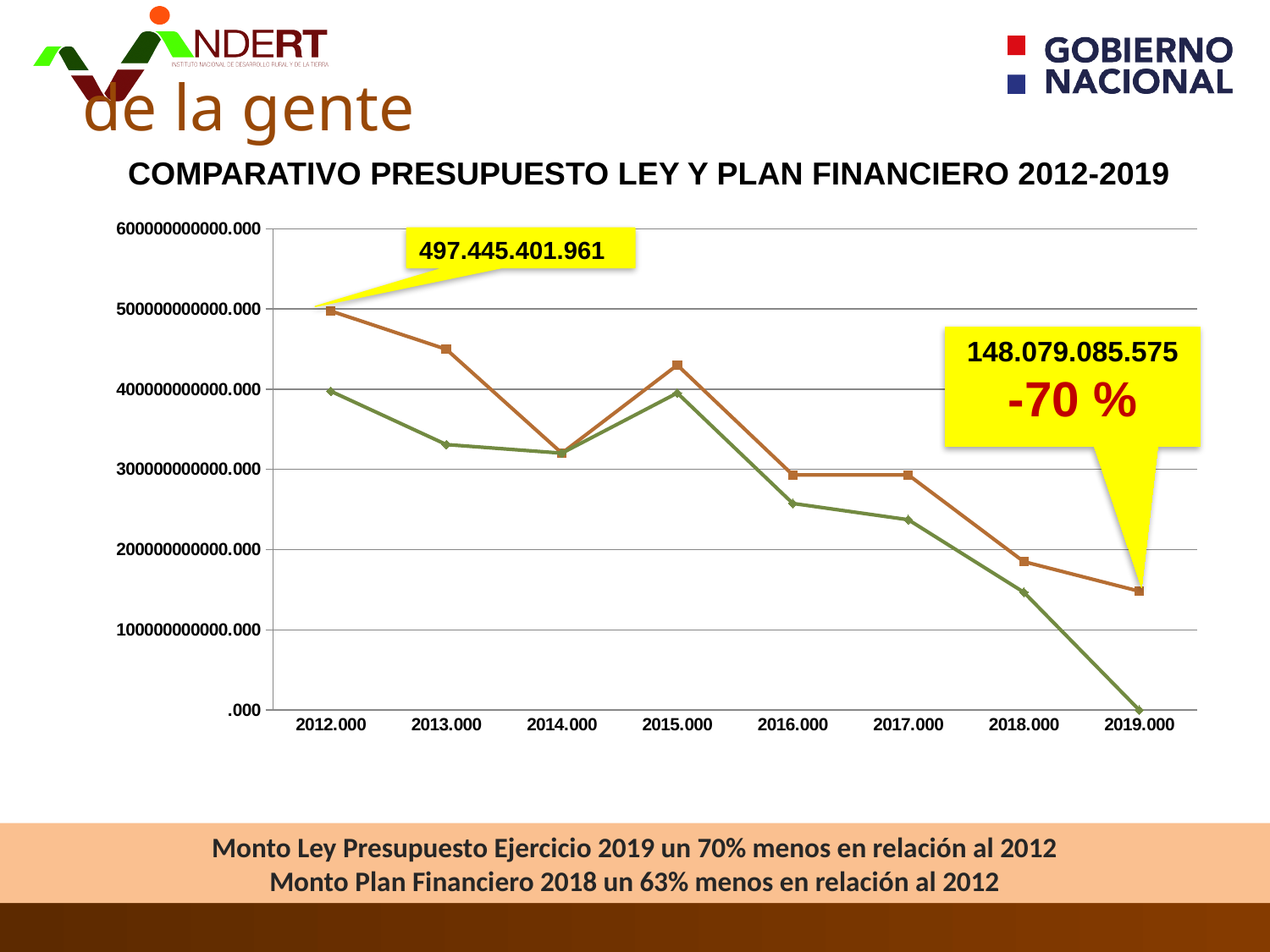
What kind of chart is shown on the slide? line chart What value is labelled for the orange line at 2019.000? 148.079.085.575 Is the value of the orange line at 2015.000 greater or less than 400000000000.000? greater At 2013.000, which line has the higher value, the orange line or the green line? the orange line How many years are shown along the x axis of the chart? 8 What is the title of the chart? COMPARATIVO PRESUPUESTO LEY Y PLAN FINANCIERO 2012-2019 What value is labelled for the orange line at 2012.000? 497.445.401.961 What is the difference between the labelled 2012.000 value (497.445.401.961) and the labelled 2019.000 value (148.079.085.575) on the orange line? 349.366.316.386 Is the value of the orange line at 2018.000 greater or less than 200000000000.000? less How many lines are plotted on the chart? 2 What percentage change is shown in the callout at 2019.000? -70 % In which year does the orange line reach its highest value? 2012.000